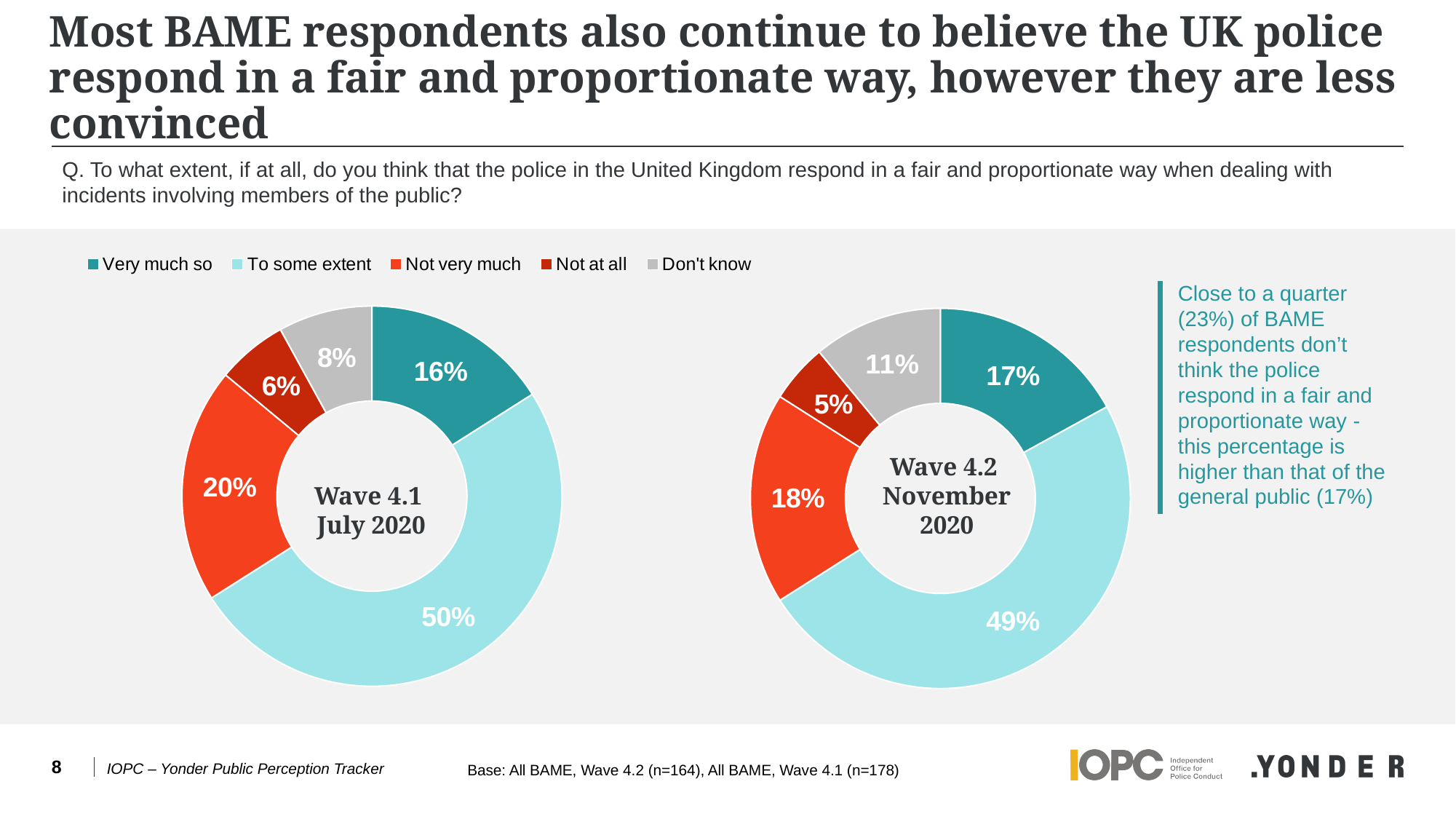
In the Wave 4.1 July 2020 chart, what percentage of respondents answered "To some extent"? 50% Which chart shows a larger share for "Don't know", Wave 4.1 July 2020 or Wave 4.2 November 2020? Wave 4.2 November 2020 In the Wave 4.2 November 2020 chart, what percentage of respondents answered "Very much so"? 17% Which colour represents "Not at all" in the legend? Dark red In the Wave 4.2 November 2020 chart, what percentage of respondents answered "Not very much"? 18% In the Wave 4.2 November 2020 chart, what is the combined share of "Very much so" and "To some extent"? 66% What is the difference between the "Not very much" share in the Wave 4.1 July 2020 chart and the Wave 4.2 November 2020 chart? 2 percentage points How many response categories are shown in each donut chart? 5 What type of chart is used on this slide? Donut (pie) chart In the Wave 4.1 July 2020 chart, what percentage of respondents answered "Don't know"? 8% In the Wave 4.2 November 2020 chart, which response category has the smallest share? Not at all In the Wave 4.1 July 2020 chart, which response category has the largest share? To some extent